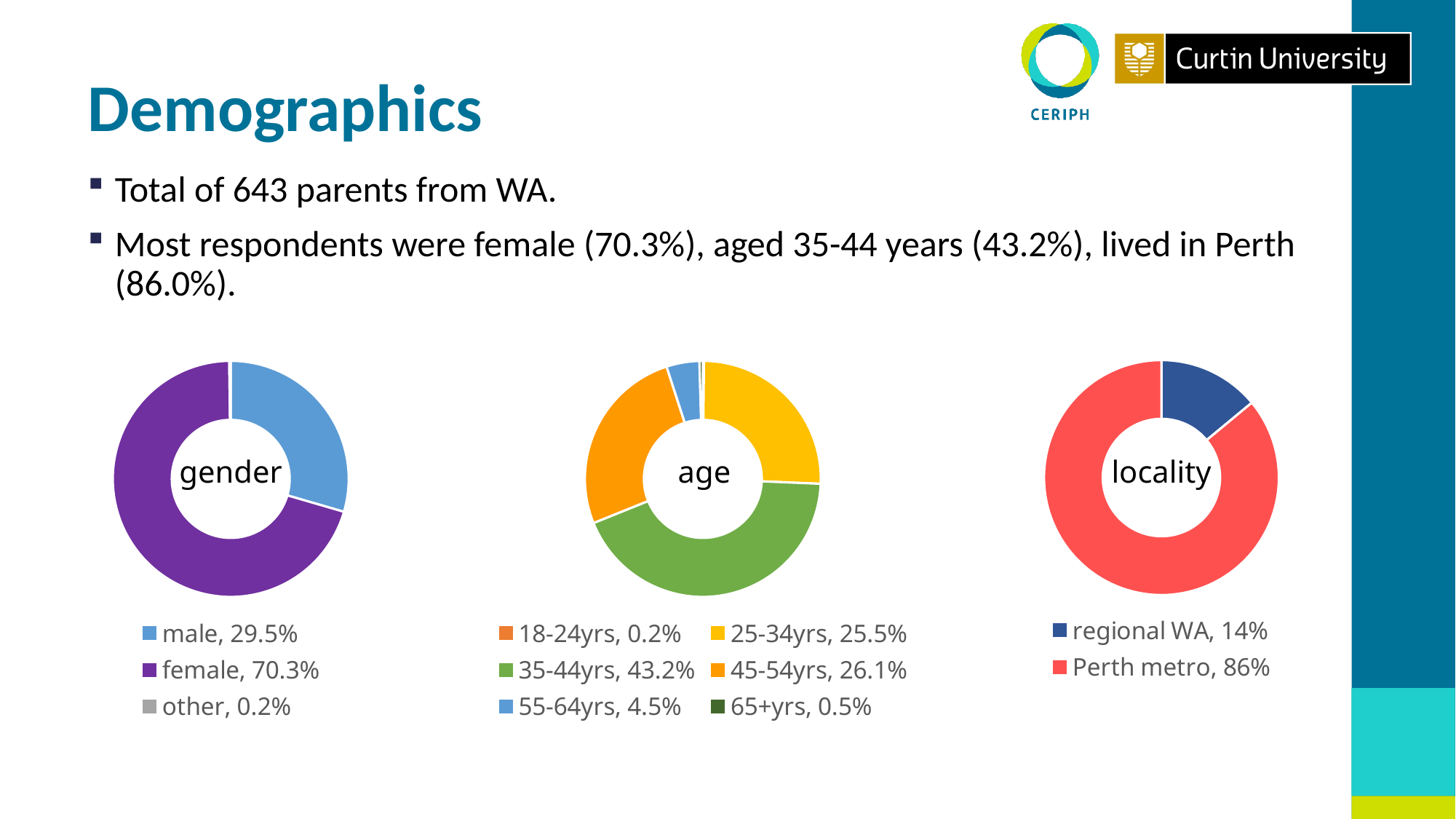
In the gender chart, what percentage of respondents were male? 29.5% In the locality chart, what percentage of respondents lived in regional WA? 14% In the gender chart, what percentage of respondents were female? 70.3% In the age chart, which is larger: the share for 25-34yrs or the share for 45-54yrs? 45-54yrs In the age chart, what percentage of respondents were aged 35-44yrs? 43.2% In the locality chart, what is the difference between the Perth metro and regional WA percentages? 72% What kind of chart is the locality chart? Doughnut chart How many categories does the legend of the age chart list? 6 In the age chart, which age group has the largest share? 35-44yrs In the age chart, which age group has the smallest share? 18-24yrs In the age chart, what percentage of respondents were aged 55-64yrs? 4.5% In the gender chart, what is the difference between the female and male percentages? 40.8%